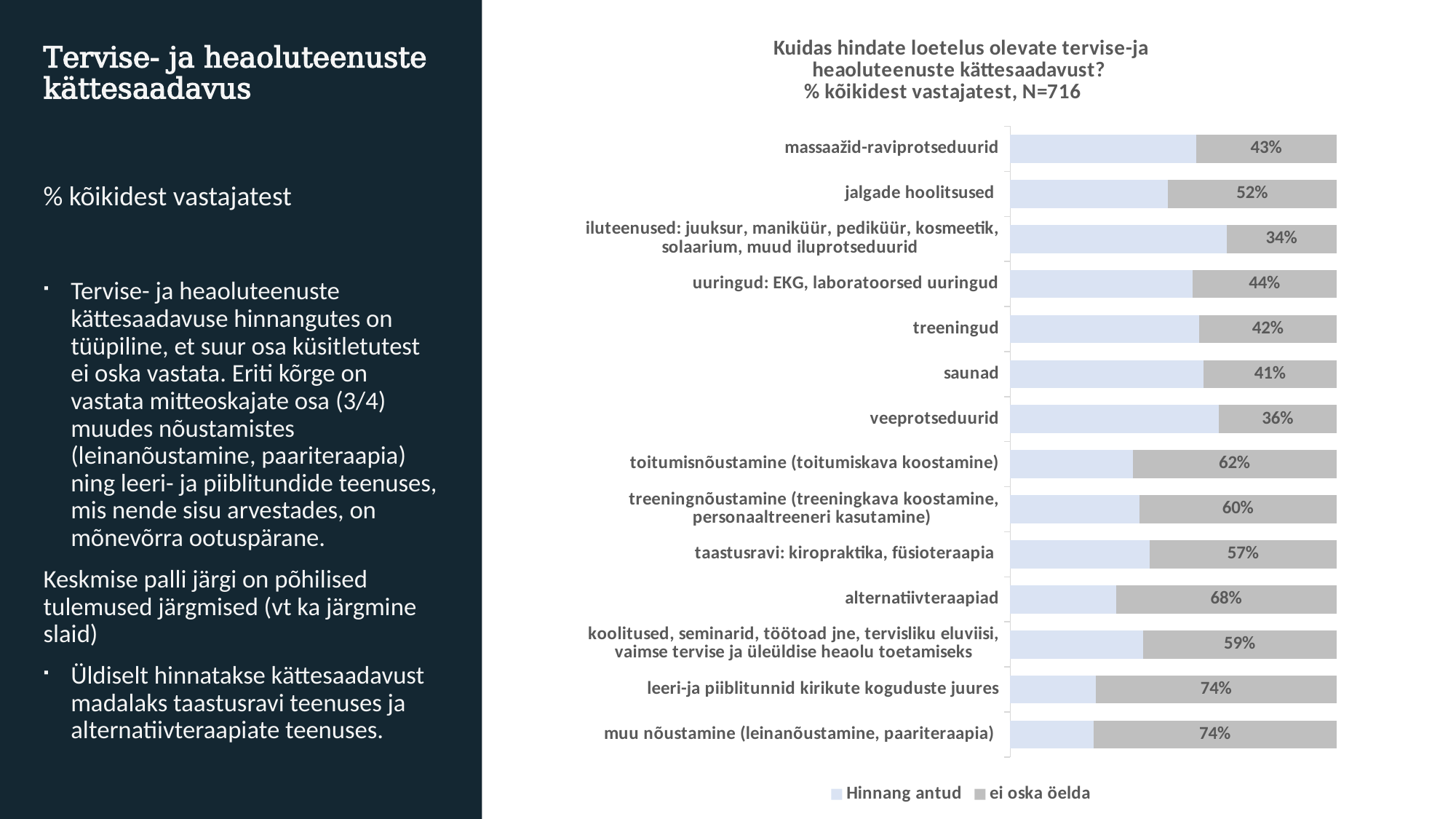
Which has a larger "ei oska öelda" share: jalgade hoolitsused or saunad? jalgade hoolitsused What kind of chart is shown on the slide? Stacked bar chart How many series does the legend list? 2 What is the "ei oska öelda" value for alternatiivteraapiad? 68% What are the two legend entries of the chart? Hinnang antud; ei oska öelda How many service categories are shown in the chart? 14 What is the "ei oska öelda" value for koolitused, seminarid, töötoad jne, tervisliku eluviisi, vaimse tervise ja üleüldise heaolu toetamiseks? 59% Which category has the lowest "ei oska öelda" share? iluteenused: juuksur, maniküür, pediküür, kosmeetik, solaarium, muud iluprotseduurid What is the difference between the "ei oska öelda" values for leeri-ja piiblitunnid kirikute koguduste juures and veeprotseduurid? 38 percentage points What is the difference between the "ei oska öelda" values for toitumisnõustamine (toitumiskava koostamine) and treeningud? 20 percentage points What is the "ei oska öelda" value for massaažid-raviprotseduurid? 43% What is the "ei oska öelda" value for taastusravi: kiropraktika, füsioteraapia? 57%